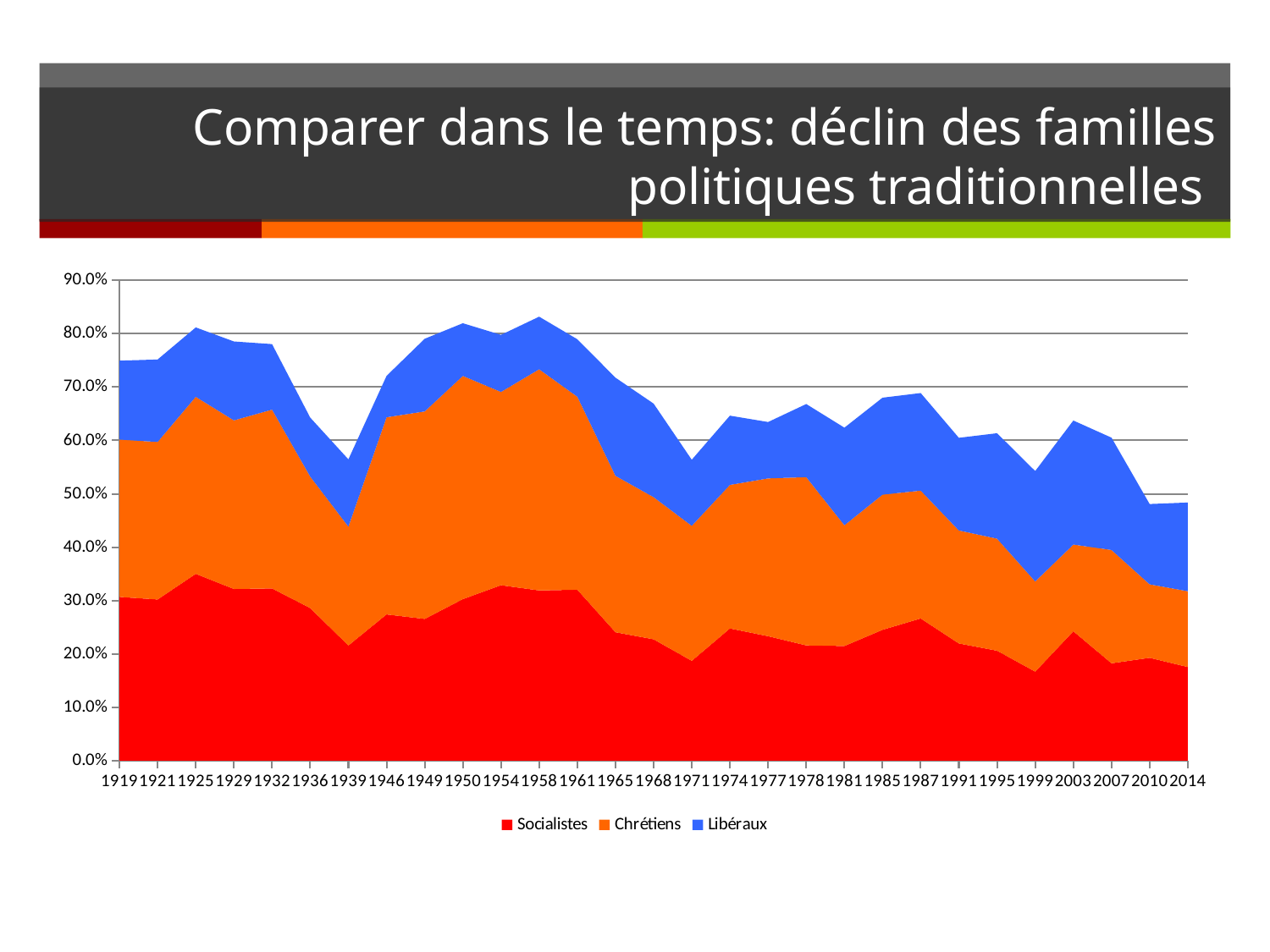
How many series does the legend list? 3 Is the value for Socialistes in 1939 greater or less than 30.0%? less Is the value for Socialistes in 1925 greater or less than 30.0%? greater Which series is shown in red? Socialistes Which is larger, the Socialistes value in 1925 or in 1939? 1925 How many years are plotted along the x axis? 29 What is the title of the slide containing the chart? Comparer dans le temps: déclin des familles politiques traditionnelles Is the combined total of the three series in 1958 greater or less than 80.0%? greater What kind of chart is shown on the slide? Stacked area chart Overall, does the combined share of the three families rise or fall from 1919 to 2014? Fall